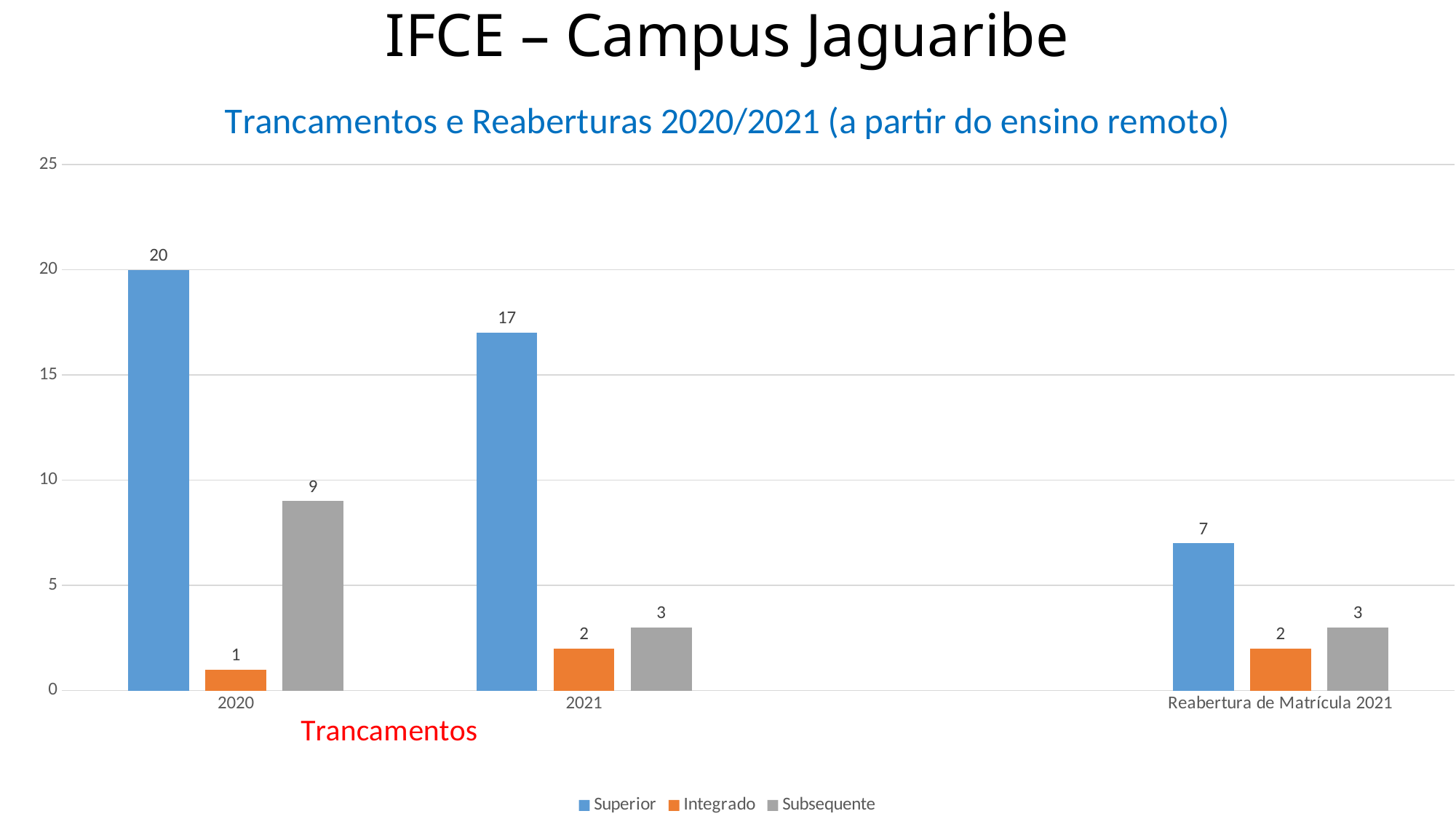
What is the difference between the Superior values for 2020 and 2021? 3 How many categories are shown on the x axis? 3 Which is larger: Subsequente in 2020 or Subsequente in 2021? Subsequente in 2020 Which series has the lowest value in 2021? Integrado What is the value for Superior in 2020? 20 Does the Superior value rise or fall from 2020 to 2021? Fall What is the title of the chart? Trancamentos e Reaberturas 2020/2021 (a partir do ensino remoto) How many series does the legend list? 3 What kind of chart is shown? Bar chart What is the value for Integrado in Reabertura de Matrícula 2021? 2 Which series has the highest value in 2020? Superior What is the value for Subsequente in 2021? 3